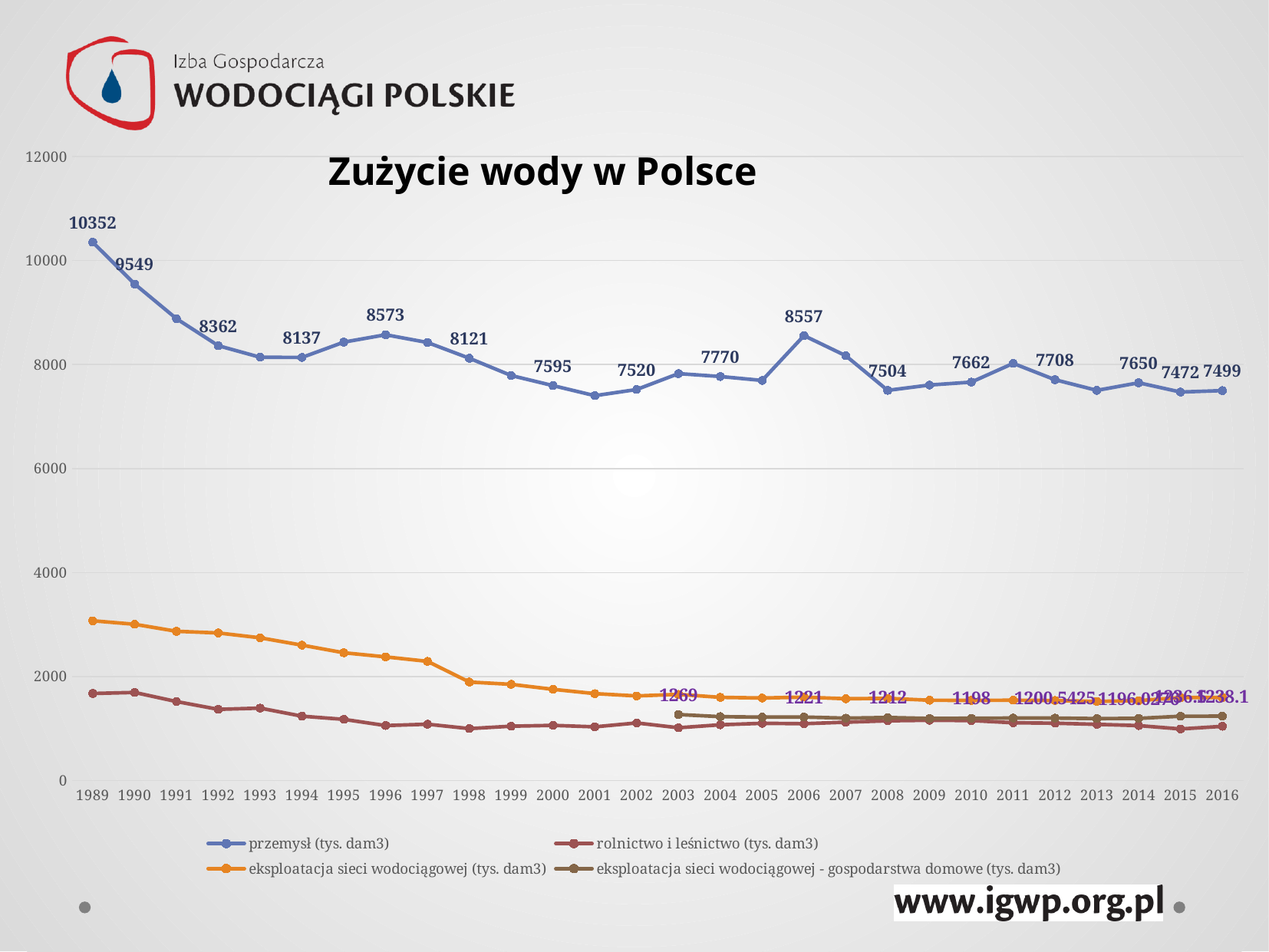
What is the difference between the przemysł values for 1989 and 1990? 803 Does the przemysł series rise or fall from 1989 to 1993? fall In which year is the value for przemysł (tys. dam3) highest? 1989 What kind of chart is shown on the slide? line chart What is the value for przemysł (tys. dam3) in 1989? 10352 How many series does the legend list? 4 Which year has the larger przemysł value, 2006 or 2008? 2006 What is the value for przemysł (tys. dam3) in 2016? 7499 How many years are shown on the x axis? 28 What is the value for eksploatacja sieci wodociągowej - gospodarstwa domowe (tys. dam3) in 2003? 1269 Is the value for eksploatacja sieci wodociągowej (tys. dam3) in 1989 greater or less than 2000? greater What is the title of the chart? Zużycie wody w Polsce